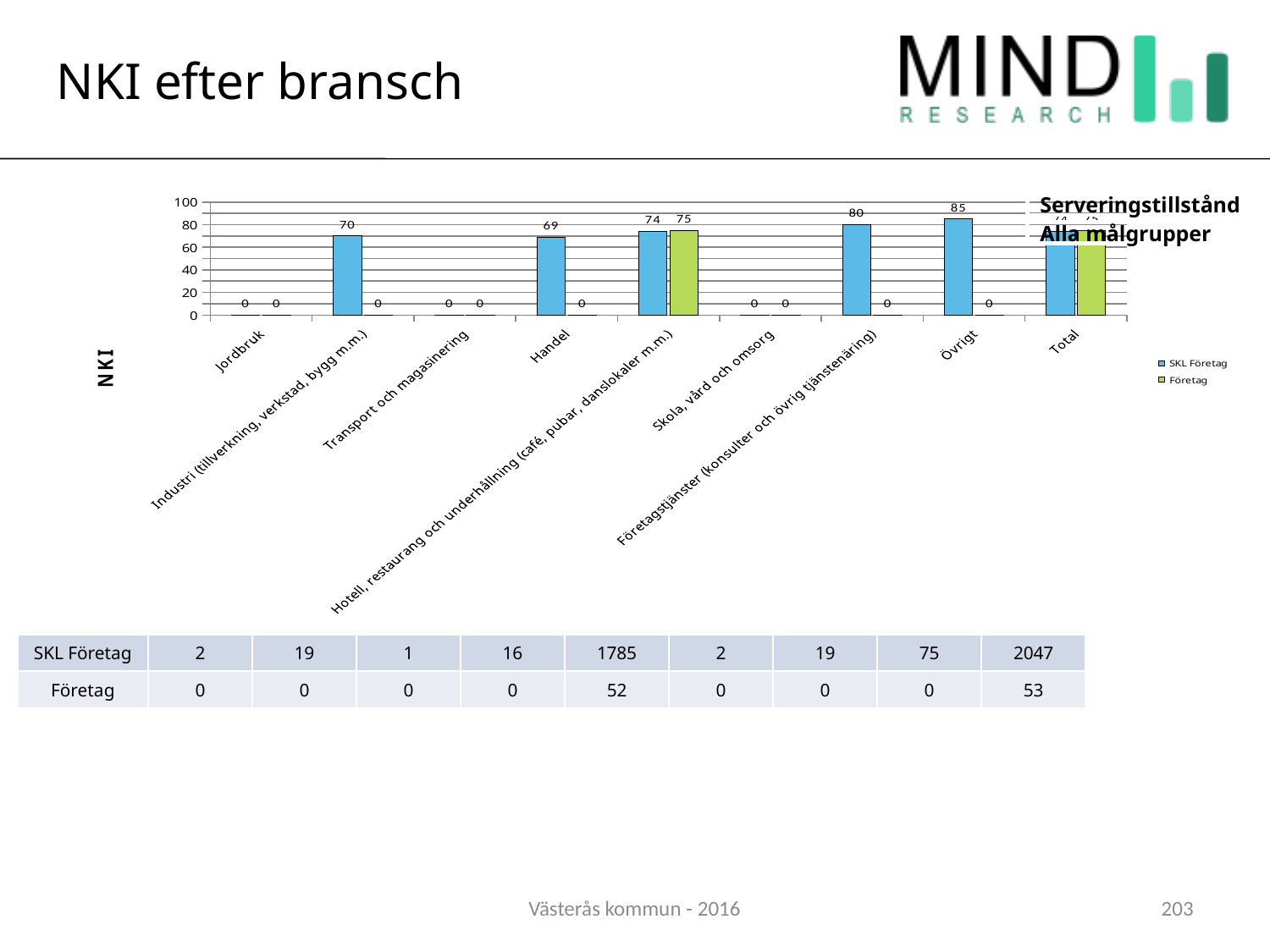
Is the SKL Företag value for Övrigt greater or less than 80? greater What is the SKL Företag value for Industri (tillverkning, verkstad, bygg m.m.)? 70 How many series does the chart legend list? 2 Which is larger: the SKL Företag value for Handel or for Företagstjänster (konsulter och övrig tjänstenäring)? Företagstjänster (konsulter och övrig tjänstenäring) What type of chart is shown on the slide? bar chart Which category has the highest SKL Företag value? Övrigt What is the SKL Företag value for Övrigt? 85 What is the Företag value for Hotell, restaurang och underhållning (café, pubar, danslokaler m.m.)? 75 What is the Företag value for Jordbruk? 0 What are the two series named in the chart legend? SKL Företag and Företag What is the SKL Företag value for Handel? 69 What is the difference between the SKL Företag values for Övrigt and Företagstjänster (konsulter och övrig tjänstenäring)? 5